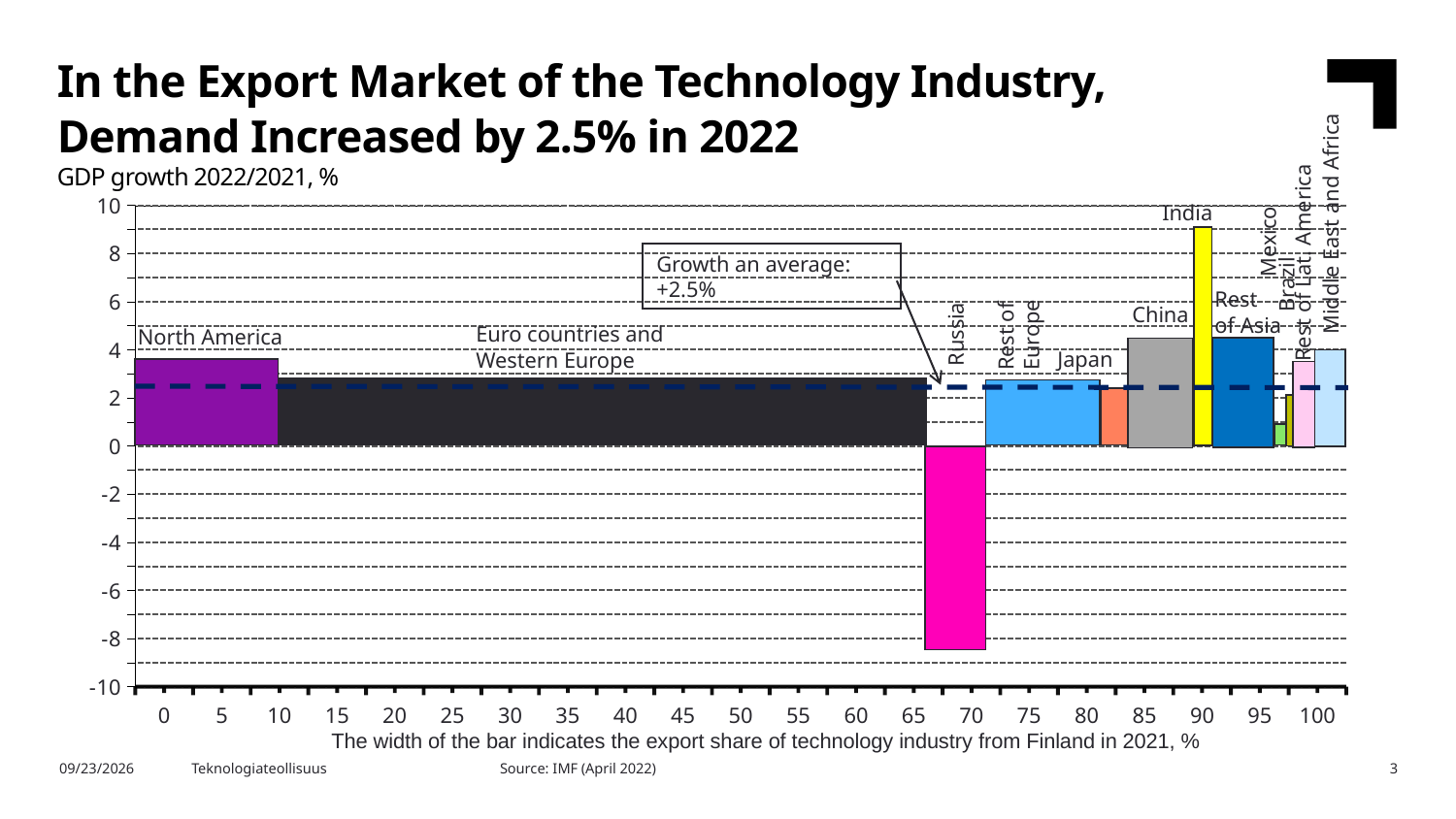
What is the average growth shown in the annotation box? +2.5% Is the GDP growth value for Brazil greater or less than 2? less Is the GDP growth value for North America greater or less than 2? greater How many regions (bars) are plotted in the chart? 12 Which has higher GDP growth, India or China? India Which has higher GDP growth, Russia or Japan? Japan Is the GDP growth value for Russia greater or less than -5? less Which region has the highest GDP growth in the chart? India Which region has the lowest GDP growth in the chart? Russia What type of chart is shown on the slide? bar chart According to the note below the x axis, what does the width of each bar indicate? The export share of technology industry from Finland in 2021, %